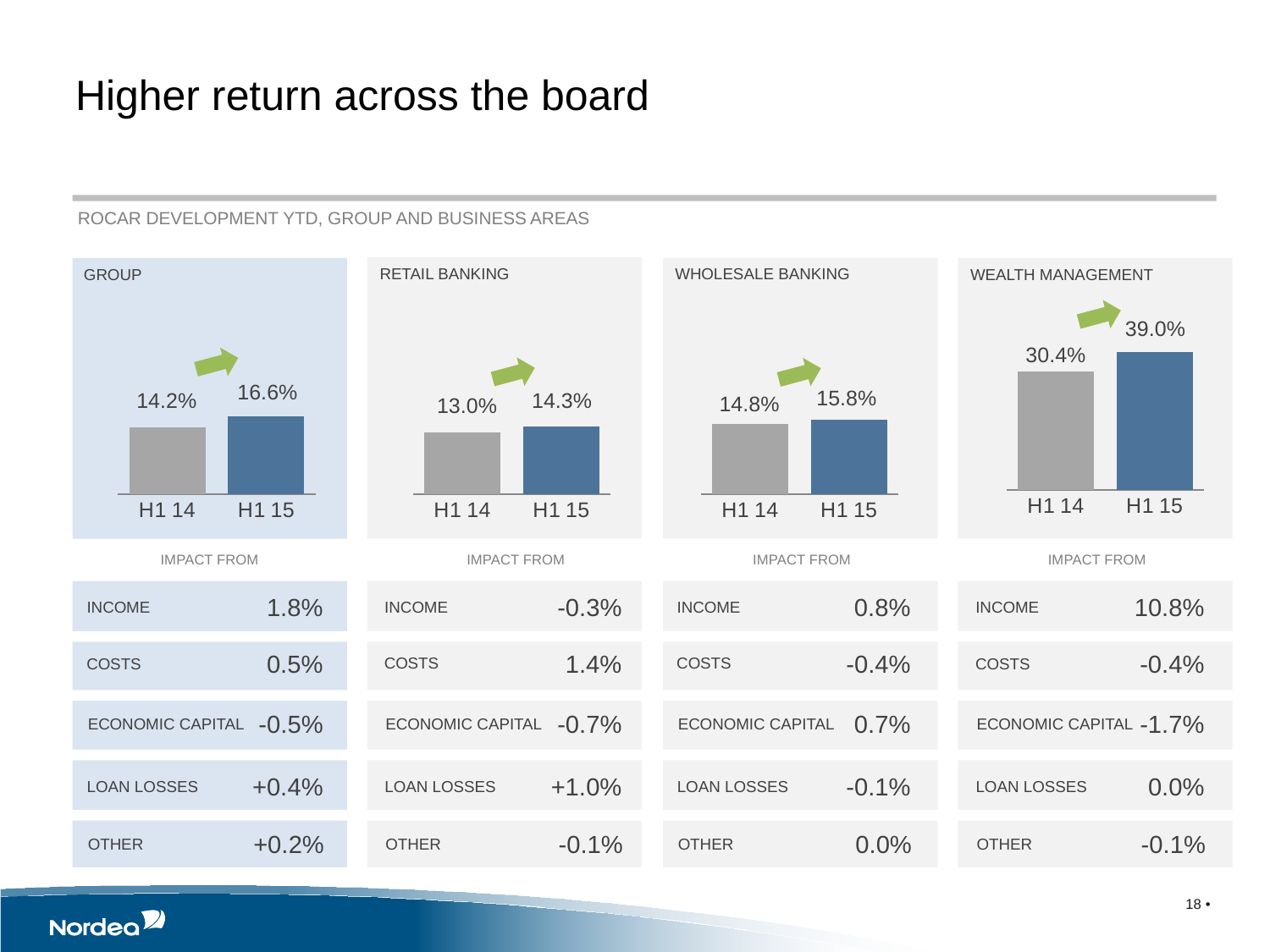
In the RETAIL BANKING chart, what is the value for H1 14? 13.0% In the GROUP chart, what is the difference between the H1 15 and H1 14 values? 2.4% In the WHOLESALE BANKING chart, do the values rise or fall from H1 14 to H1 15? rise Which of the four charts shows the highest H1 15 value? WEALTH MANAGEMENT In the WEALTH MANAGEMENT chart, what is the value for H1 14? 30.4% In the WHOLESALE BANKING chart, what is the value for H1 15? 15.8% How many bars are shown in the GROUP chart? 2 Which of the four charts shows the lowest H1 14 value? RETAIL BANKING What type of chart is used in the WHOLESALE BANKING panel? bar chart In the RETAIL BANKING chart, which period has the higher value, H1 14 or H1 15? H1 15 In the GROUP chart, what is the ROCAR value for H1 15? 16.6% In the WEALTH MANAGEMENT chart, by how much did the value increase from H1 14 to H1 15? 8.6%